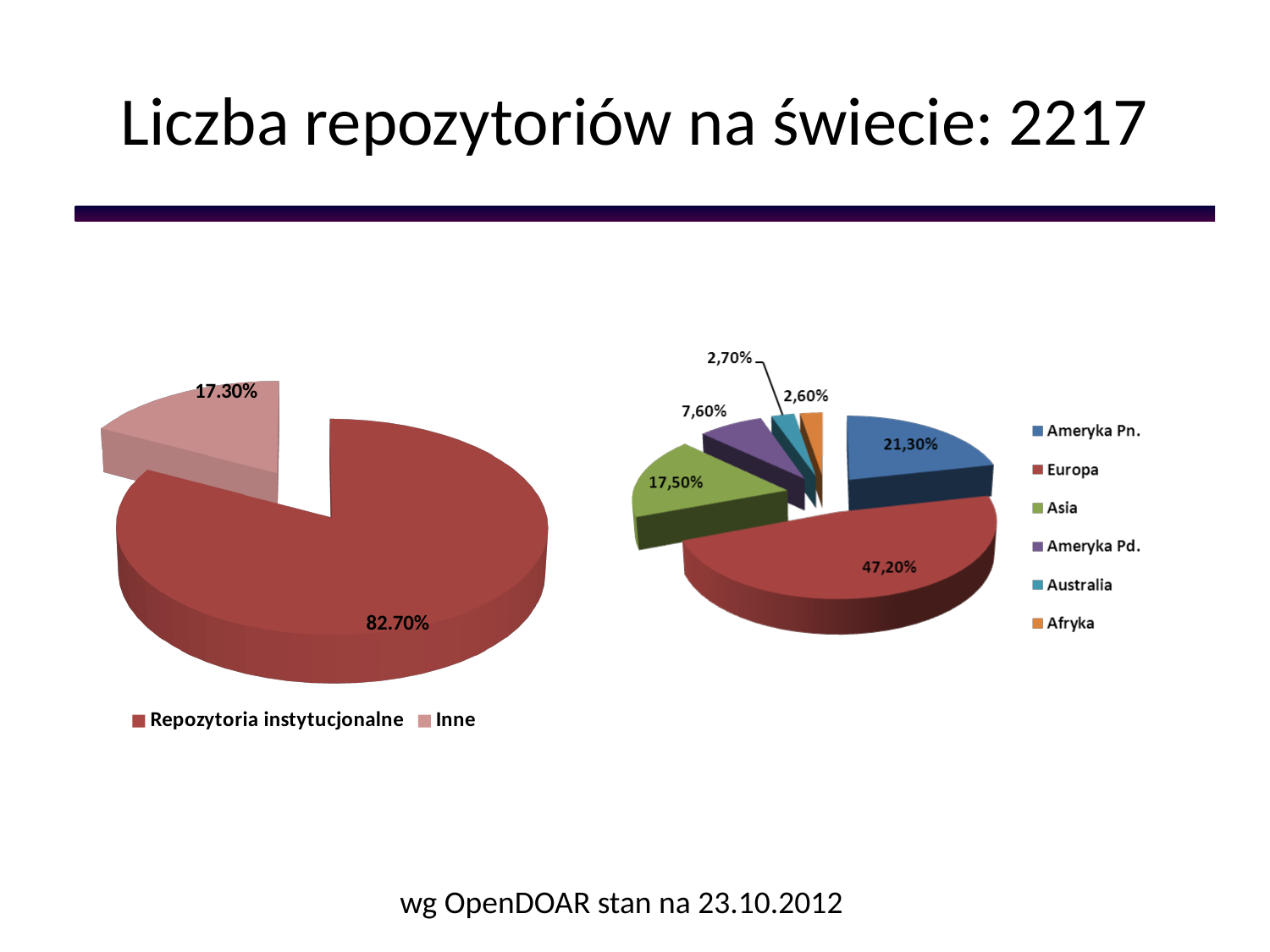
On the left pie chart, what is the difference between the shares for Repozytoria instytucjonalne and Inne? 65.40% On the right pie chart, what share is shown for Ameryka Pd.? 7,60% On the right pie chart, what share is shown for Ameryka Pn.? 21,30% What type of chart is shown on the right side of the slide? Pie chart On the left pie chart, how many slices does the pie have? 2 On the left pie chart, what share is shown for Repozytoria instytucjonalne? 82.70% On the right pie chart, which is larger, the share for Ameryka Pn. or the share for Asia? Ameryka Pn. On the right pie chart, how many regions does the legend list? 6 On the right pie chart, what share is shown for Europa? 47,20% On the right pie chart, which region has the largest share? Europa On the right pie chart, what share is shown for Asia? 17,50% On the left pie chart, what share is shown for Inne? 17.30%